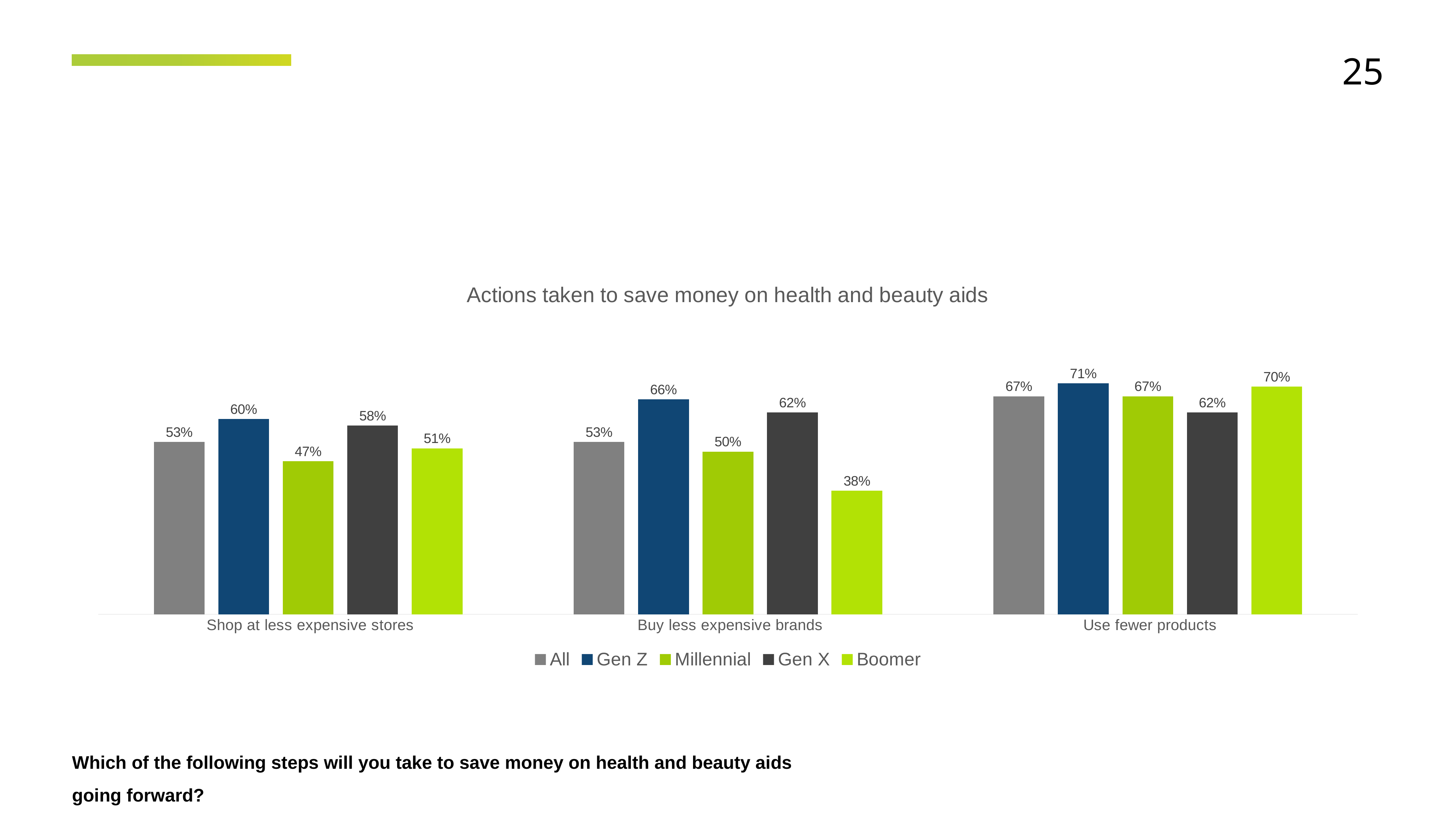
How many series does the legend list? 5 What is the difference between the Gen Z and Millennial values in the 'Shop at less expensive stores' category? 13% What kind of chart is shown on the slide? Bar chart Which series has the highest value in the 'Use fewer products' category? Gen Z What is the difference between the Boomer values for 'Use fewer products' and 'Buy less expensive brands'? 32% Which is larger in the 'Buy less expensive brands' category: Gen X or Millennial? Gen X What is the value for Gen X in the 'Use fewer products' category? 62% What is the title of the chart? Actions taken to save money on health and beauty aids How many categories are shown on the x axis? 3 What is the value for Boomer in the 'Shop at less expensive stores' category? 51% Which series has the lowest value in the 'Buy less expensive brands' category? Boomer What is the value for Gen Z in the 'Buy less expensive brands' category? 66%